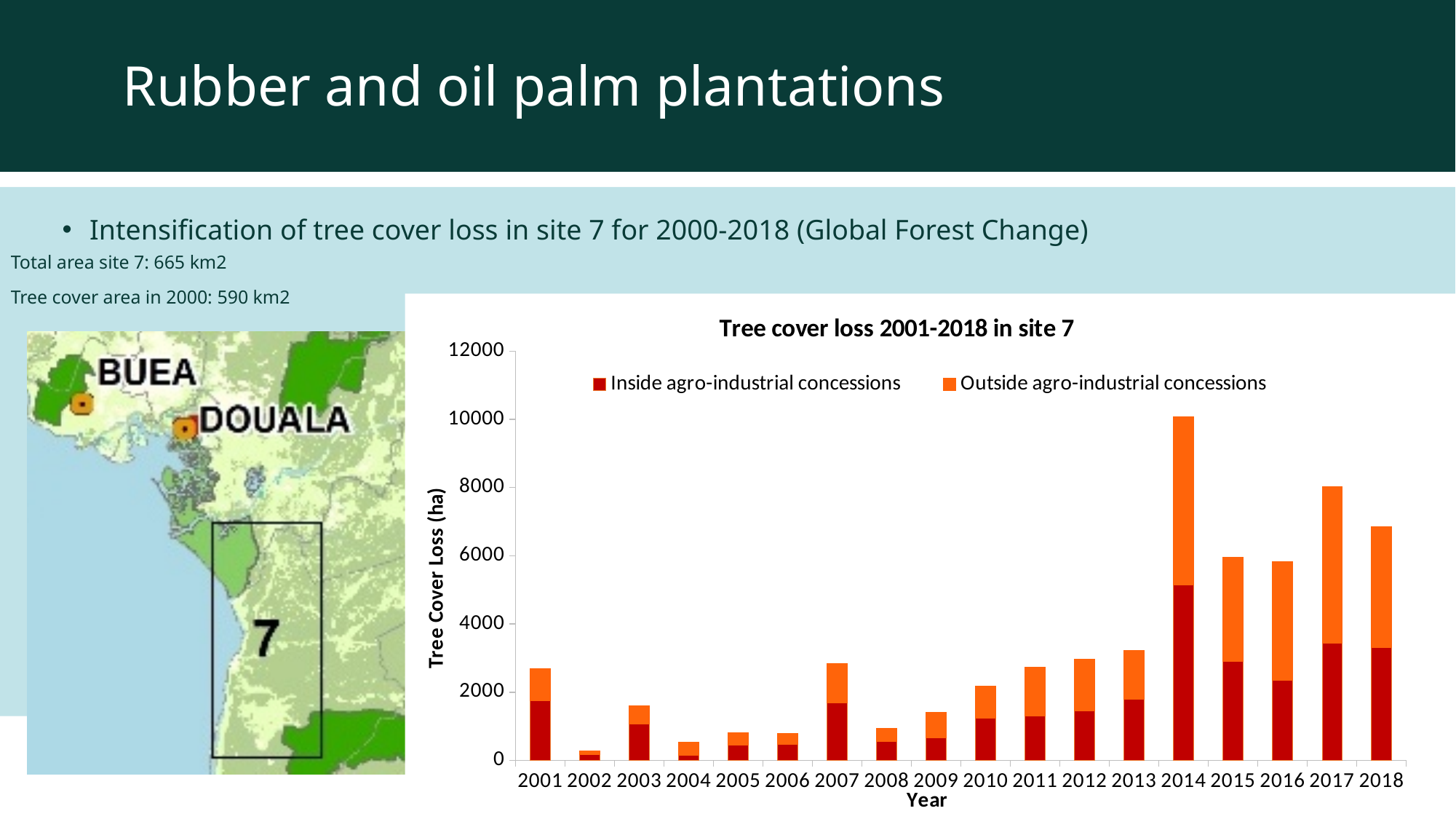
Is the total tree cover loss for 2014 greater or less than 8000? greater Is the total tree cover loss for 2018 greater or less than 6000? greater What kind of chart is shown on the slide? Stacked bar chart Which year has the larger tree cover loss inside agro-industrial concessions, 2014 or 2017? 2014 How many years are plotted on the x axis of the chart? 18 How many series does the chart legend list? 2 Which year has the lowest total tree cover loss in the chart? 2002 Do the total tree cover loss values rise or fall from 2008 to 2014? rise Is the total tree cover loss for 2002 greater or less than 1000? less Which year has the larger total tree cover loss, 2017 or 2018? 2017 Which year has the highest total tree cover loss in the chart? 2014 What is the title of the chart? Tree cover loss 2001-2018 in site 7